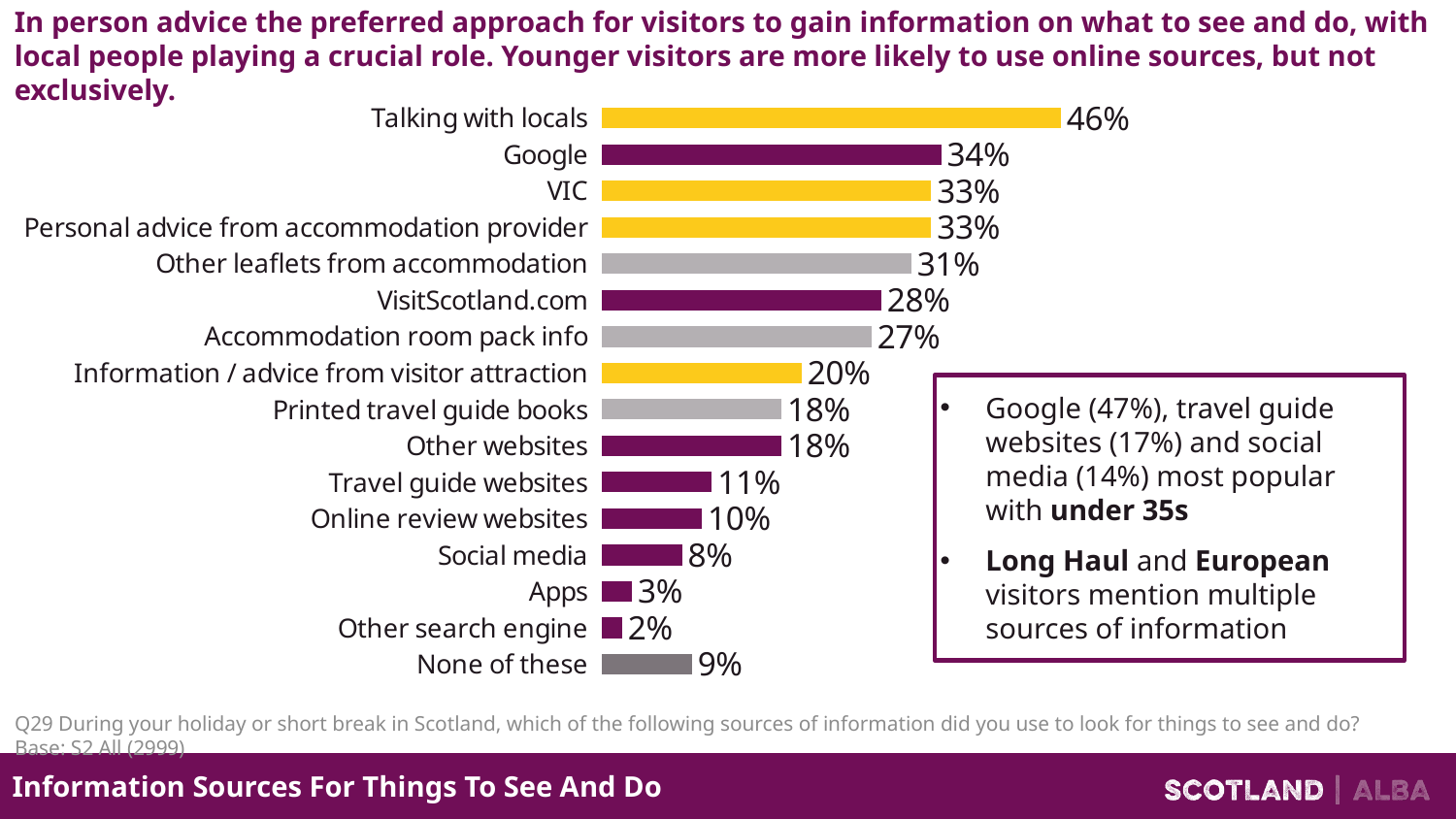
What is the difference in percentage points between Apps and Other search engine? 1 What percentage is shown for Social media? 8% Which has a higher value, None of these or Social media? None of these Which information source has the highest percentage? Talking with locals What value is shown for Accommodation room pack info? 27% What is the value shown for VisitScotland.com? 28% How many information source categories are shown in the chart? 16 What is the difference in percentage points between Talking with locals and Google? 12 Which information source has the lowest percentage? Other search engine What type of chart is used on this slide? Bar chart What percentage of visitors used talking with locals as an information source? 46% Which has a higher value, Online review websites or Travel guide websites? Travel guide websites